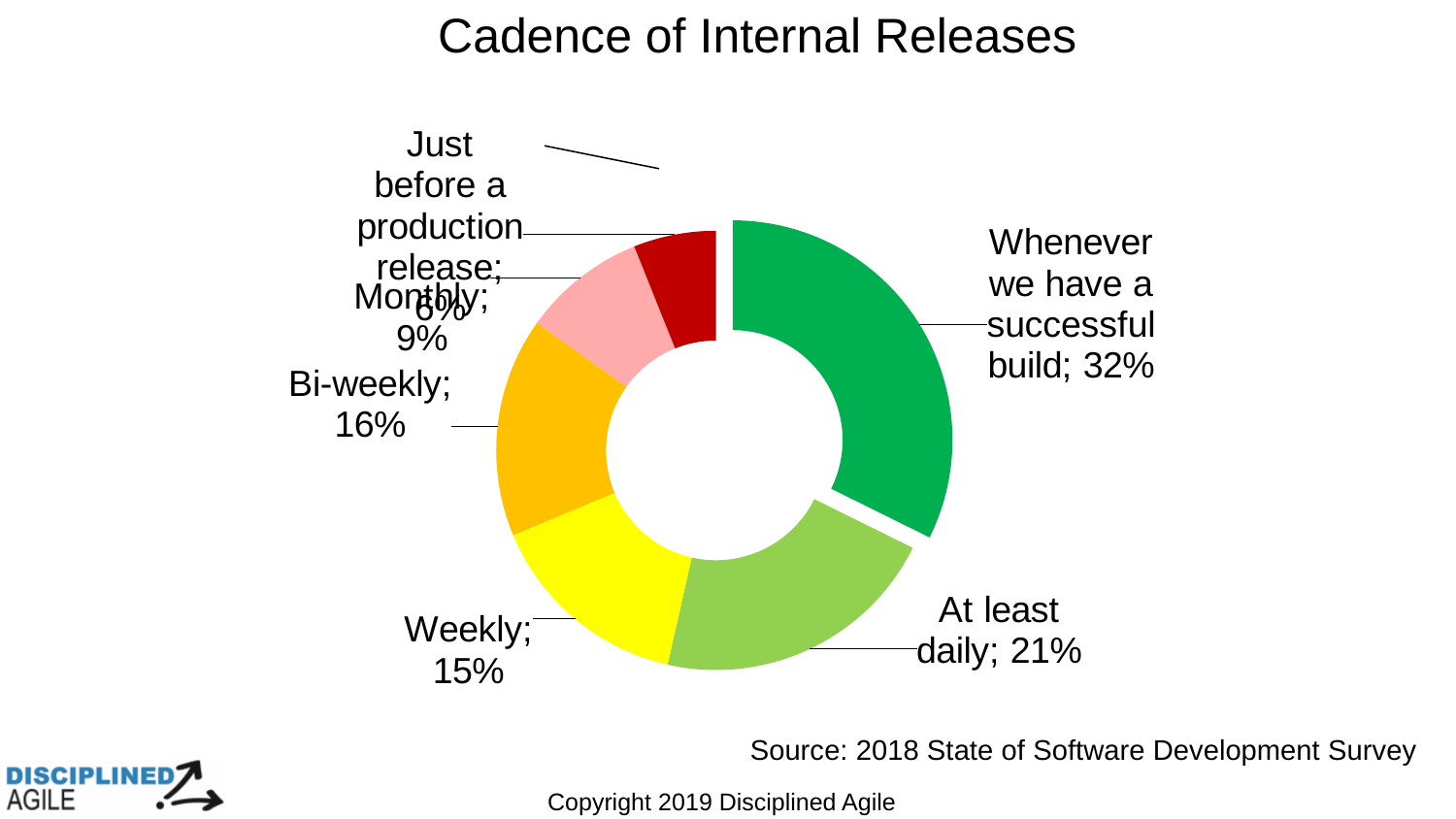
What is the value for 'Bi-weekly'? 16% Which is larger, the share for 'Bi-weekly' or the share for 'Weekly'? Bi-weekly Which release cadence has the smallest share? Just before a production release What is the difference between the 'Whenever we have a successful build' share and the 'At least daily' share? 11% What kind of chart is shown on the slide? Doughnut (pie) chart What percentage of respondents release internally whenever they have a successful build? 32% What is the value for 'Weekly'? 15% What is the value for 'Monthly'? 9% Which release cadence has the largest share? Whenever we have a successful build What is the value for 'At least daily'? 21% How many categories are shown in the chart? 6 What is the title of the chart? Cadence of Internal Releases